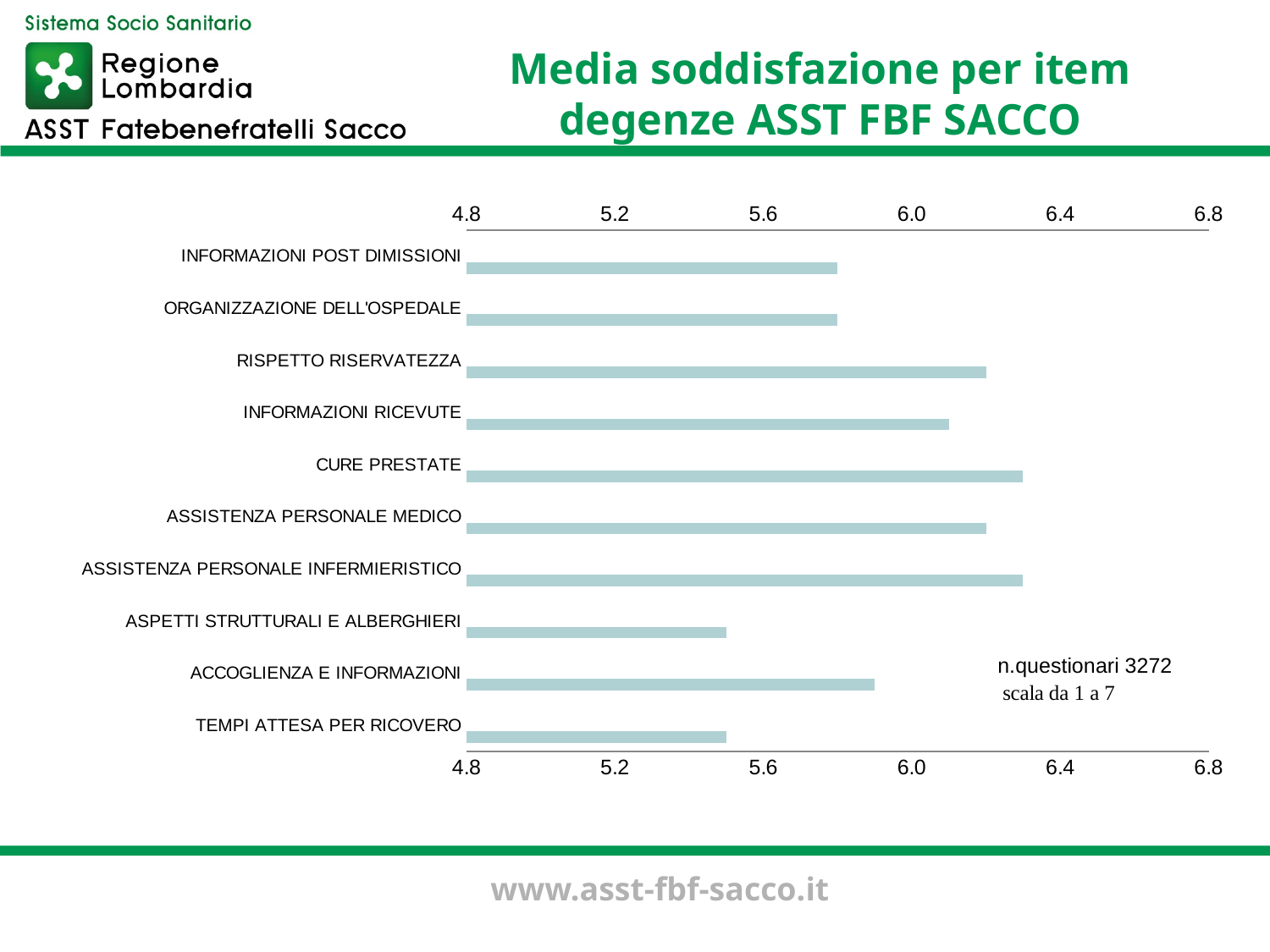
Is the value for INFORMAZIONI POST DIMISSIONI greater or less than 6.0? less Which has a higher value: CURE PRESTATE or ASPETTI STRUTTURALI E ALBERGHIERI? CURE PRESTATE According to the note on the chart, how many questionnaires (n.questionari) were collected? 3272 Which has a higher value: TEMPI ATTESA PER RICOVERO or RISPETTO RISERVATEZZA? RISPETTO RISERVATEZZA Is the value for ASPETTI STRUTTURALI E ALBERGHIERI greater or less than 5.6? less Is the value for ASSISTENZA PERSONALE INFERMIERISTICO greater or less than 6.4? less How many items (categories) are plotted in the chart? 10 What is the title of the chart on the slide? Media soddisfazione per item degenze ASST FBF SACCO What kind of chart is shown on the slide? bar chart